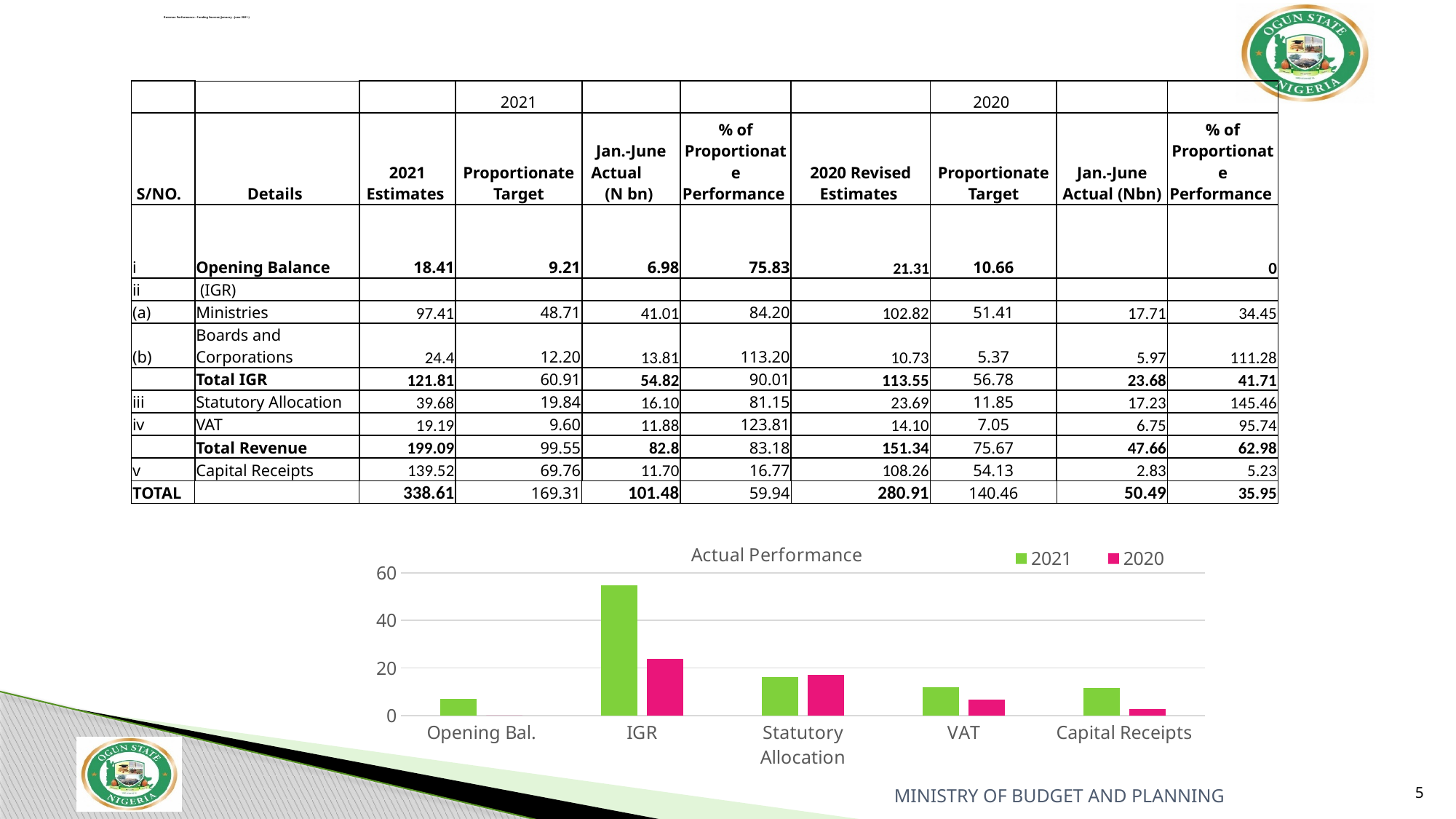
What is the title of the chart on the slide? Actual Performance Which category has the highest 2021 bar in the chart? IGR How many categories are shown along the x axis of the chart? 5 What kind of chart is shown below the table on the slide? bar chart For VAT, which series has the larger bar, 2021 or 2020? 2021 For IGR, which series has the larger bar, 2021 or 2020? 2021 Is the 2020 value for Capital Receipts greater or less than 20? less Is the 2020 value for IGR greater or less than 40? less Is the 2021 value for IGR greater or less than 40? greater How many series does the chart's legend list? 2 Which category has the highest 2020 bar in the chart? IGR Which category has the lowest 2021 bar in the chart? Opening Bal.